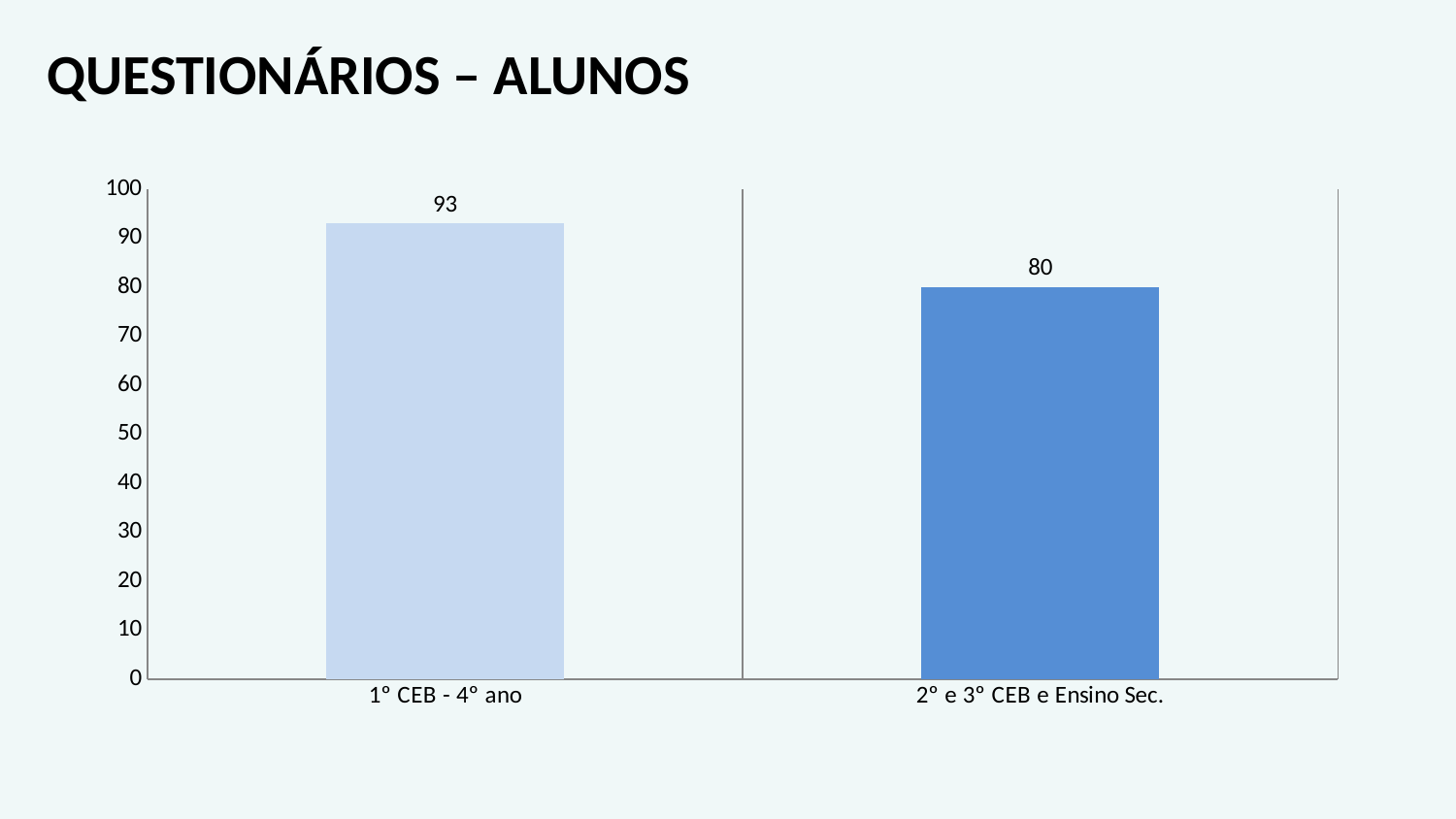
Is the value for 1º CEB - 4º ano greater or less than 90? greater Is the value for 2º e 3º CEB e Ensino Sec. greater or less than 90? less How many categories are shown in the chart? 2 What is the maximum value shown on the vertical axis? 100 What is the value for 2º e 3º CEB e Ensino Sec.? 80 Which category has the highest value? 1º CEB - 4º ano What is the difference between the values for 1º CEB - 4º ano and 2º e 3º CEB e Ensino Sec.? 13 What is the title of the slide? QUESTIONÁRIOS – ALUNOS What kind of chart is shown on the slide? bar chart Which category has the lowest value? 2º e 3º CEB e Ensino Sec. What is the value for 1º CEB - 4º ano? 93 Which is larger, the value for 1º CEB - 4º ano or the value for 2º e 3º CEB e Ensino Sec.? 1º CEB - 4º ano